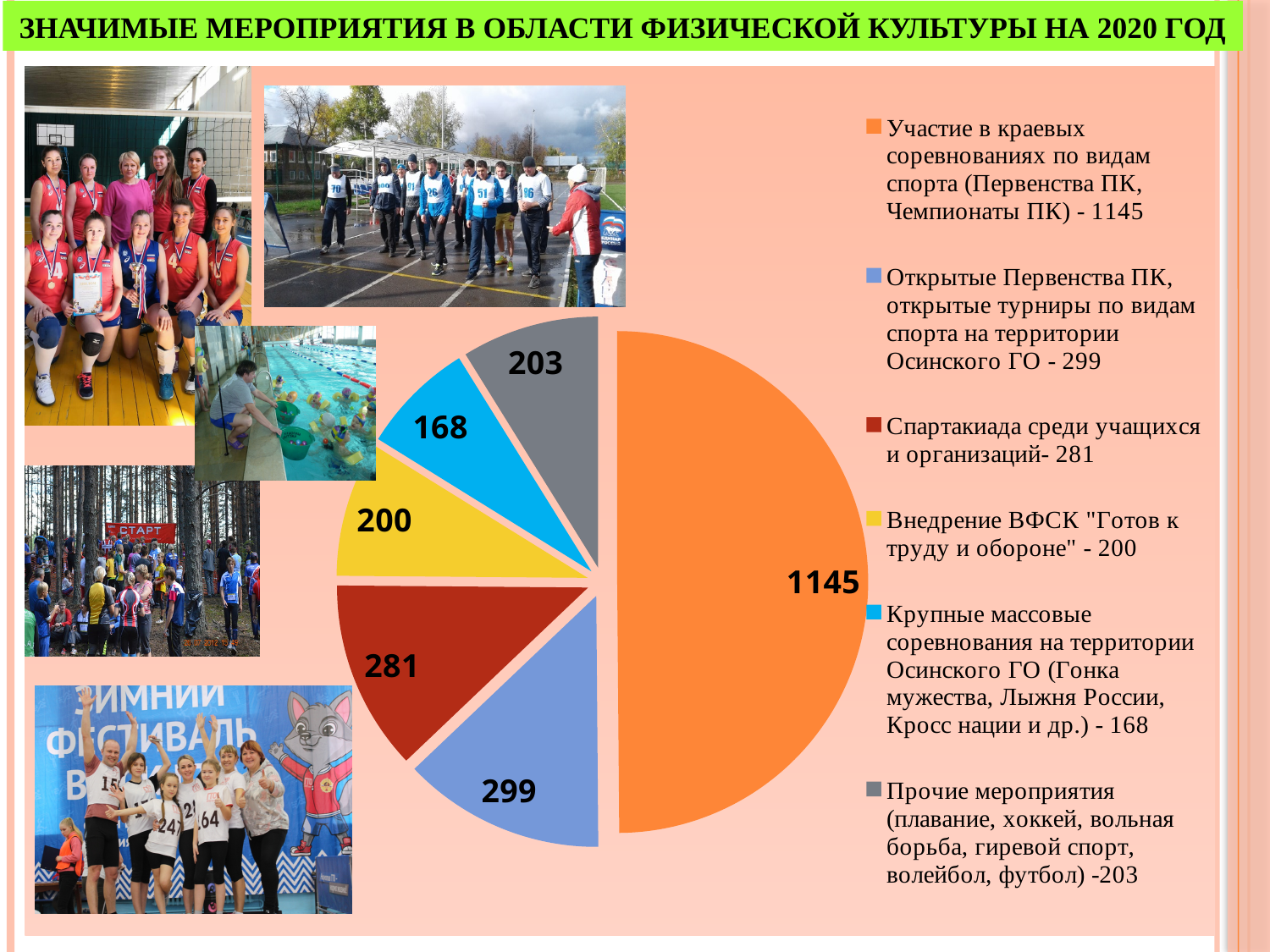
How many entries does the legend of the pie chart list? 6 What type of chart is shown on the slide? pie chart What colour is the slice for "Крупные массовые соревнования на территории Осинского ГО"? light blue Which category has the largest slice in the pie chart? Участие в краевых соревнованиях по видам спорта (Первенства ПК, Чемпионаты ПК) What is the difference between the value for "Открытые Первенства ПК, открытые турниры по видам спорта на территории Осинского ГО" and the value for "Спартакиада среди учащихся и организаций"? 18 Which category has the smallest slice in the pie chart? Крупные массовые соревнования на территории Осинского ГО (Гонка мужества, Лыжня России, Кросс нации и др.) What is the value of the slice for "Участие в краевых соревнованиях по видам спорта (Первенства ПК, Чемпионаты ПК)"? 1145 How many slices does the pie chart have? 6 What is the value of the slice for "Прочие мероприятия (плавание, хоккей, вольная борьба, гиревой спорт, волейбол, футбол)"? 203 What is the value of the slice for "Спартакиада среди учащихся и организаций"? 281 Which is larger: the slice for "Прочие мероприятия" or the slice for "Внедрение ВФСК "Готов к труду и обороне""? Прочие мероприятия What is the value of the slice for "Внедрение ВФСК "Готов к труду и обороне""? 200